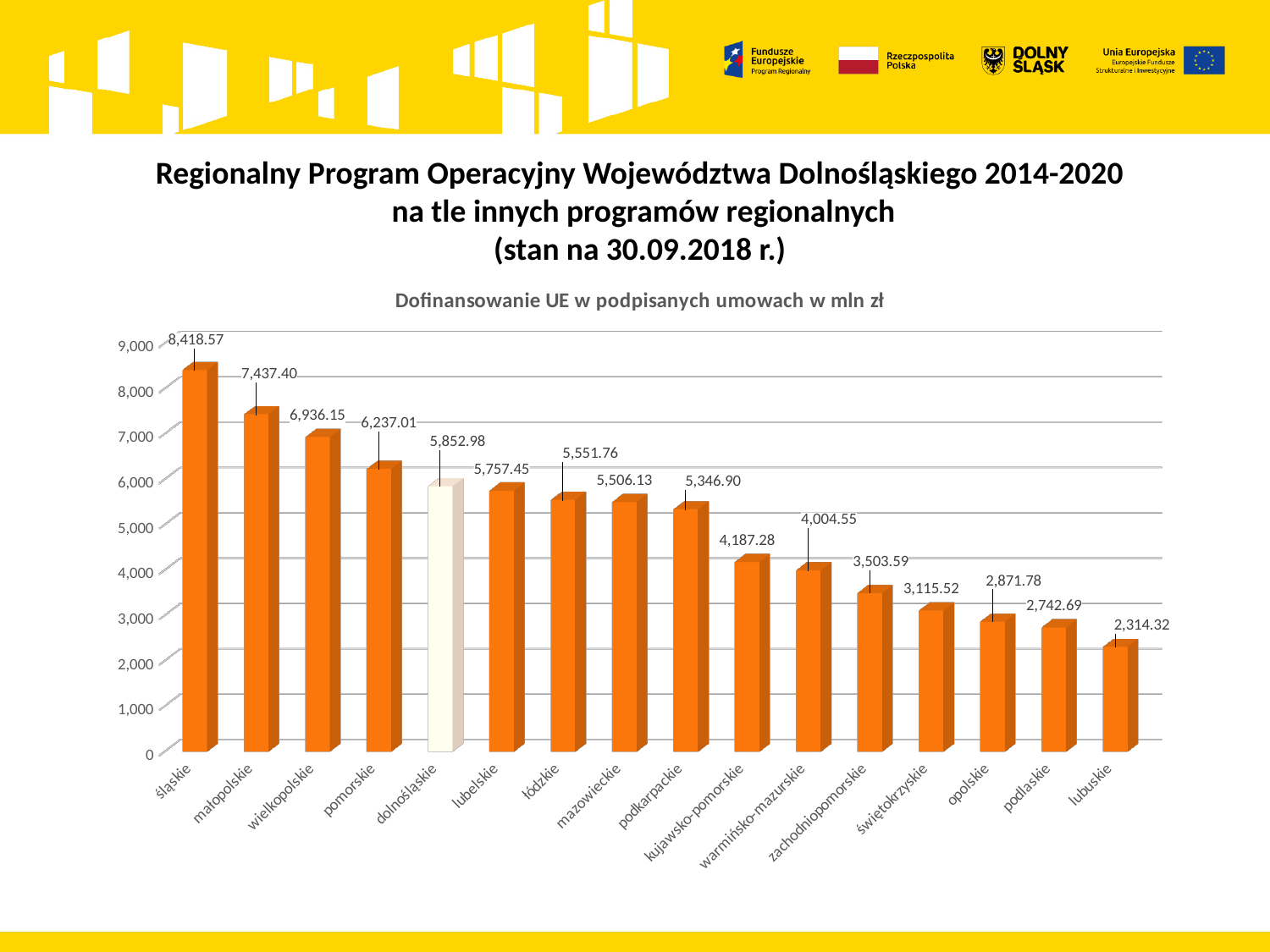
What is the value for dolnośląskie in the chart? 5,852.98 Which has a larger value, pomorskie or lubelskie? pomorskie Is the value for kujawsko-pomorskie greater or less than 5,000? less Which bar is shown in a different colour from the others? dolnośląskie What is the difference between the values for dolnośląskie and lubuskie? 3,538.66 What is the difference between the values for śląskie and małopolskie? 981.17 How many regions are shown in the chart? 16 Which region has the highest value in the chart? śląskie What is the value for lubuskie in the chart? 2,314.32 What is the value for śląskie in the chart? 8,418.57 Which region has the lowest value in the chart? lubuskie What kind of chart is shown on the slide? bar chart